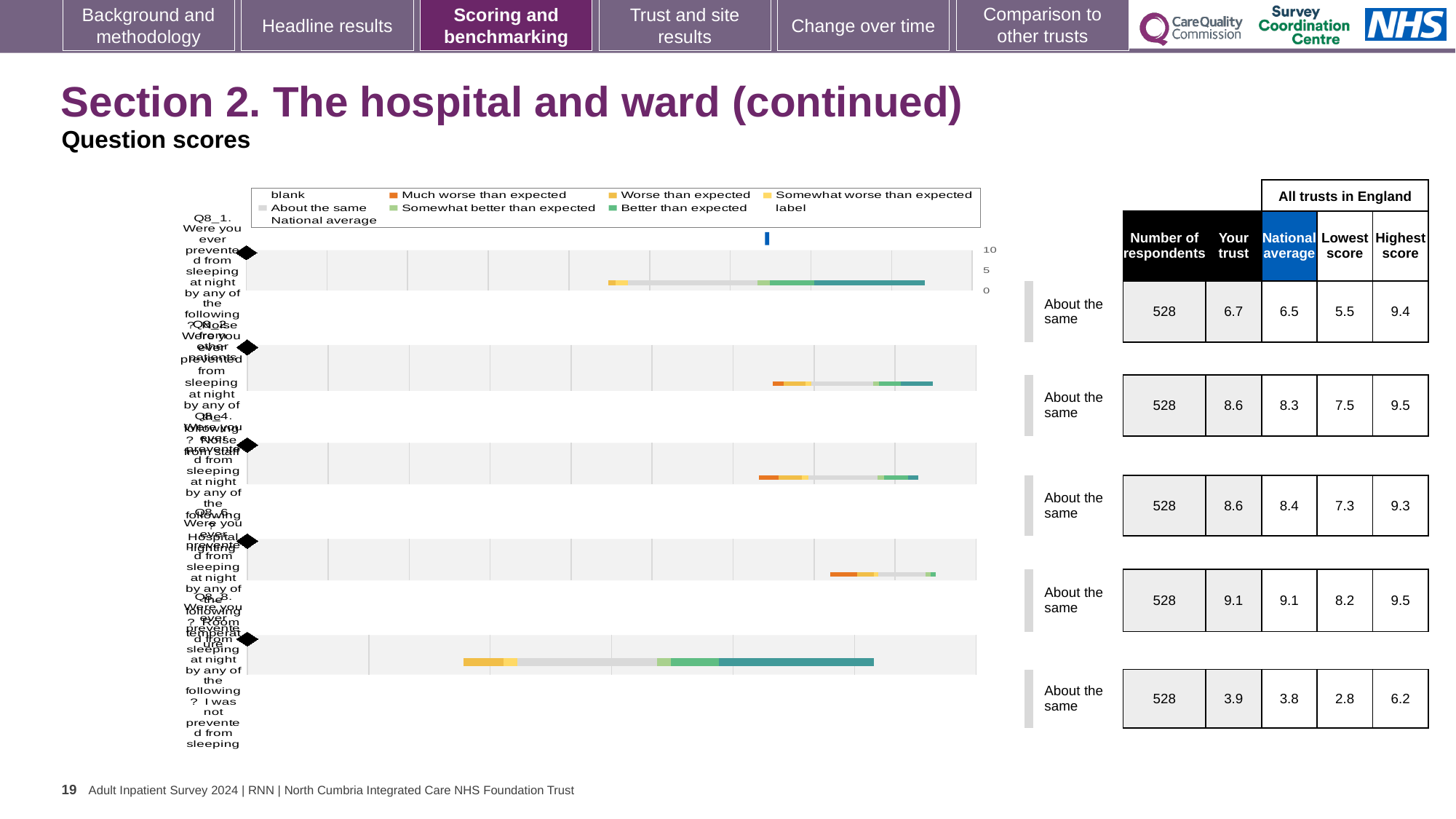
How many question rows (bars) are plotted in the chart? 5 What is the 'Your trust' score for the first row (Q8_1)? 6.7 In the chart legend, which colour represents 'Much worse than expected'? orange What is the highest score across all trusts in England for the last row (Q8_8)? 6.2 What kind of chart is shown on the slide? bar chart Which row has the lowest 'Your trust' score? Q8_8 For the second row (Q8_2), which is larger: the 'Your trust' score or the national average? Your trust Which row has the highest 'Your trust' score? Q8_6 In the chart legend, which colour represents 'Better than expected'? teal What is the number of respondents shown for the first row (Q8_1)? 528 What is the national average for the last row (Q8_8)? 3.8 For the first row (Q8_1), what is the difference between the 'Your trust' score and the national average? 0.2